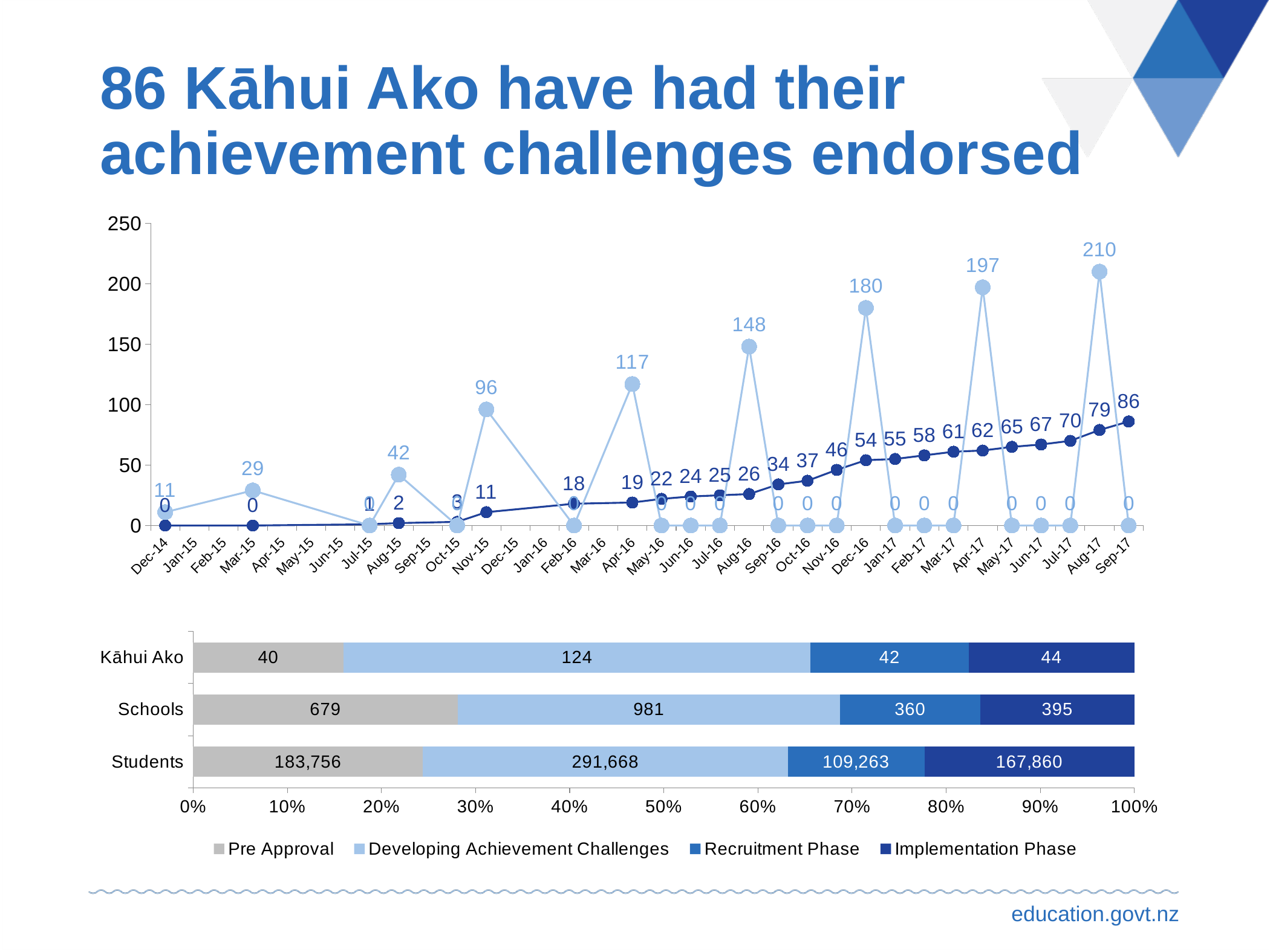
In the bottom stacked bar chart, how many series does the legend list? 4 In the bottom stacked bar chart, how many categories are shown on the vertical axis? 3 In the top line chart, does the dark blue line generally rise or fall from Dec-14 to Sep-17? Rise In the bottom stacked bar chart, what is the total of the Kāhui Ako bar? 250 In the bottom stacked bar chart, what is the Pre Approval value for Kāhui Ako? 40 What kind of chart is the bottom chart on the slide? Stacked bar chart In the bottom stacked bar chart, what is the Developing Achievement Challenges value for Schools? 981 In the top line chart, what is the value of the dark blue line at Sep-17? 86 In the top line chart, at which month does the light blue line reach its highest value? Aug-17 In the bottom stacked bar chart, what is the Implementation Phase value for Students? 167,860 In the bottom stacked bar chart, what is the difference between the Implementation Phase and Recruitment Phase values for Schools? 35 In the top line chart, what is the value of the light blue line at Aug-17? 210